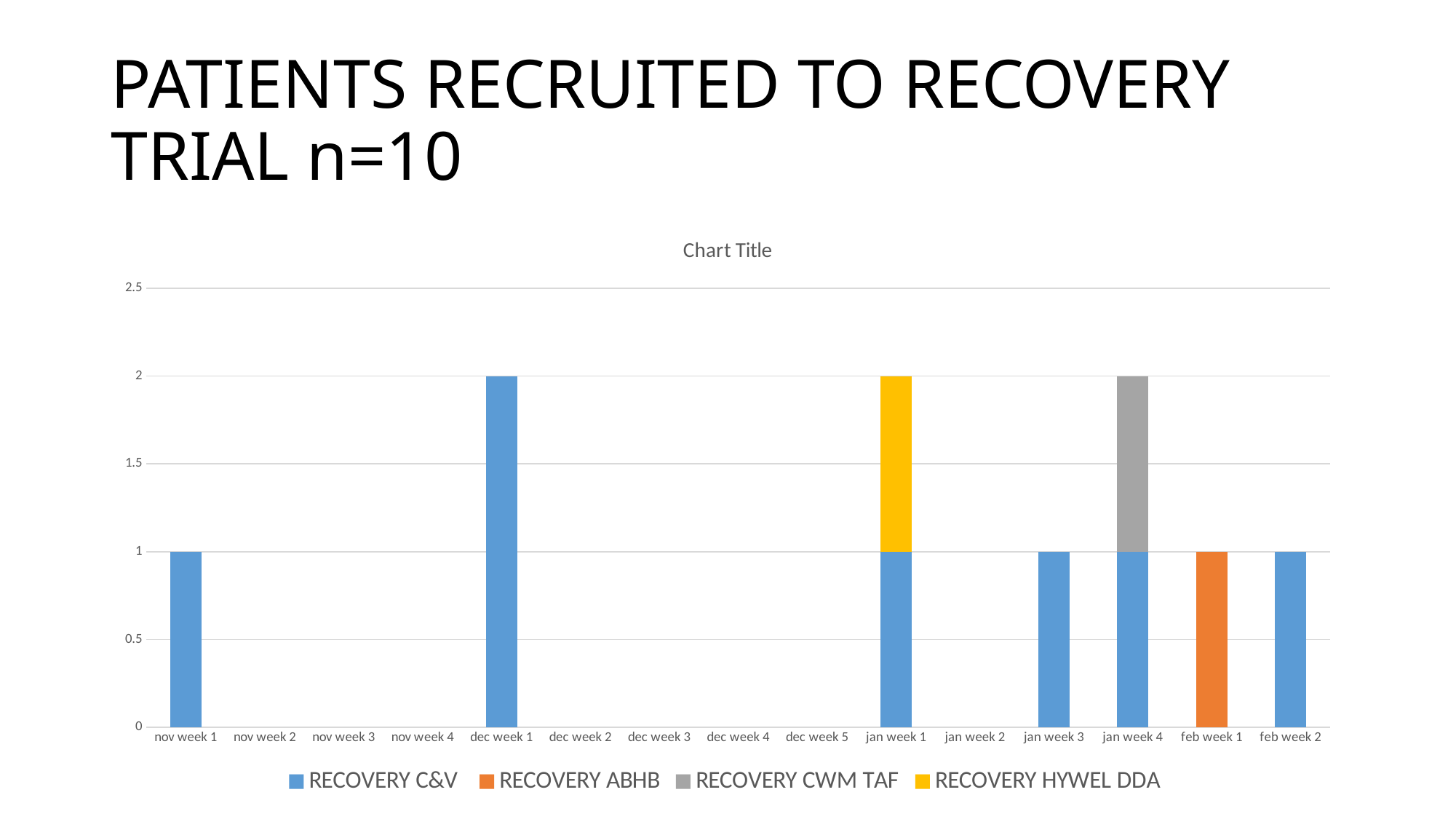
Which series is shown in grey in the legend? RECOVERY CWM TAF What is the difference between the RECOVERY C&V value in dec week 1 and in feb week 2? 1 What kind of chart is shown on the slide? stacked bar chart How many week categories are shown on the x axis? 15 What is the value for RECOVERY C&V in nov week 1? 1 What is the value for RECOVERY ABHB in feb week 1? 1 How many series does the legend list? 4 What is the value for RECOVERY HYWEL DDA in jan week 1? 1 Which is larger, the RECOVERY C&V value in dec week 1 or in jan week 3? dec week 1 What is the value for RECOVERY C&V in dec week 1? 2 What is the total height of the stacked bar for jan week 4? 2 What is the total height of the stacked bar for jan week 1? 2